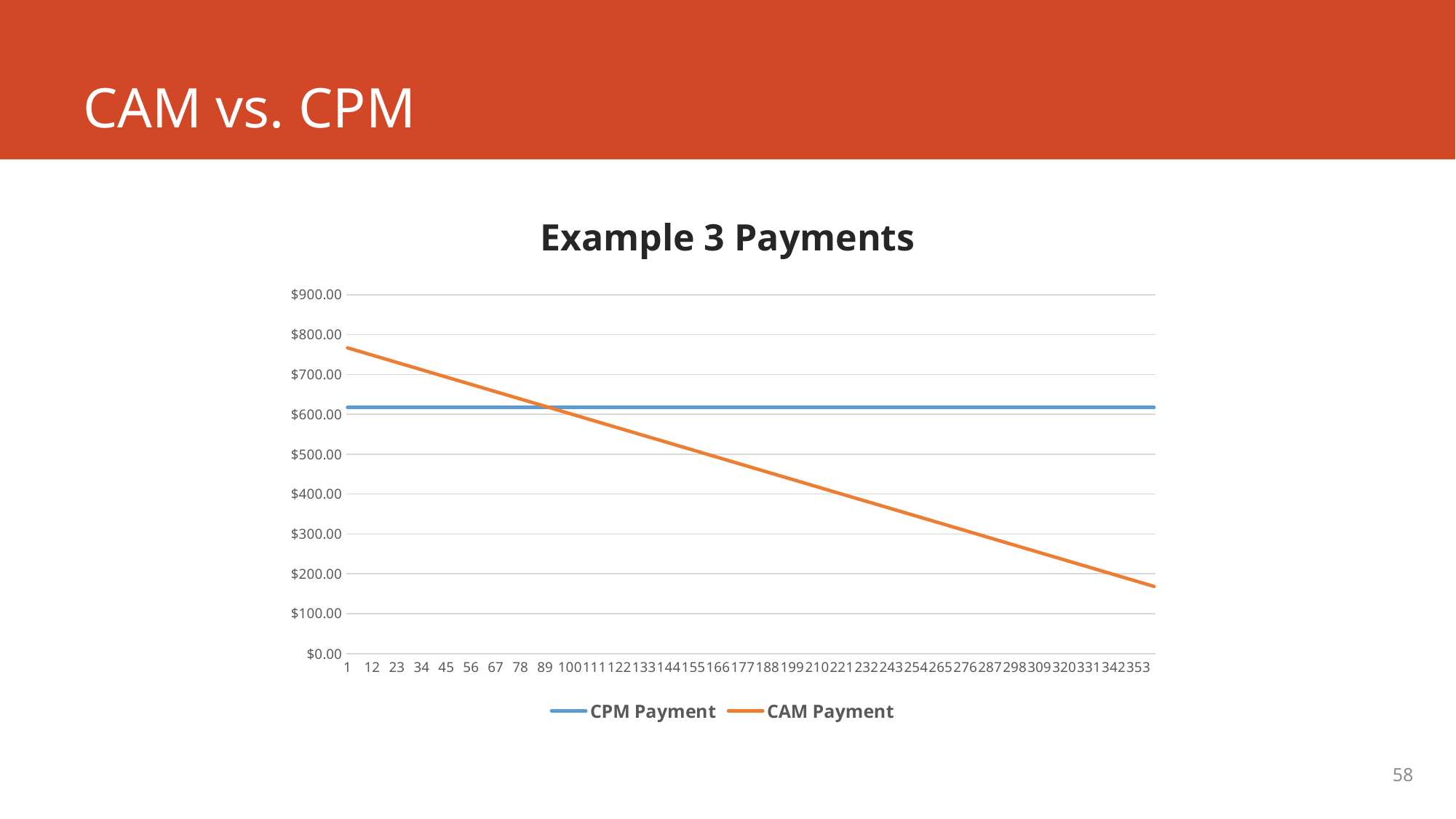
Is the CAM Payment value at period 199 greater or less than $500.00? less Which series is drawn in orange? CAM Payment Is the CAM Payment value at period 353 greater or less than $200.00? less What is the title of the chart? Example 3 Payments Is the CAM Payment value at period 1 greater or less than $700.00? greater Does the CPM Payment line rise, fall, or stay flat along the x axis? stay flat At period 353, which is larger, the CAM Payment or the CPM Payment? CPM Payment At period 1, which is larger, the CAM Payment or the CPM Payment? CAM Payment Does the CAM Payment line rise or fall along the x axis? fall What kind of chart is shown on the slide? line chart How many series does the legend list? 2